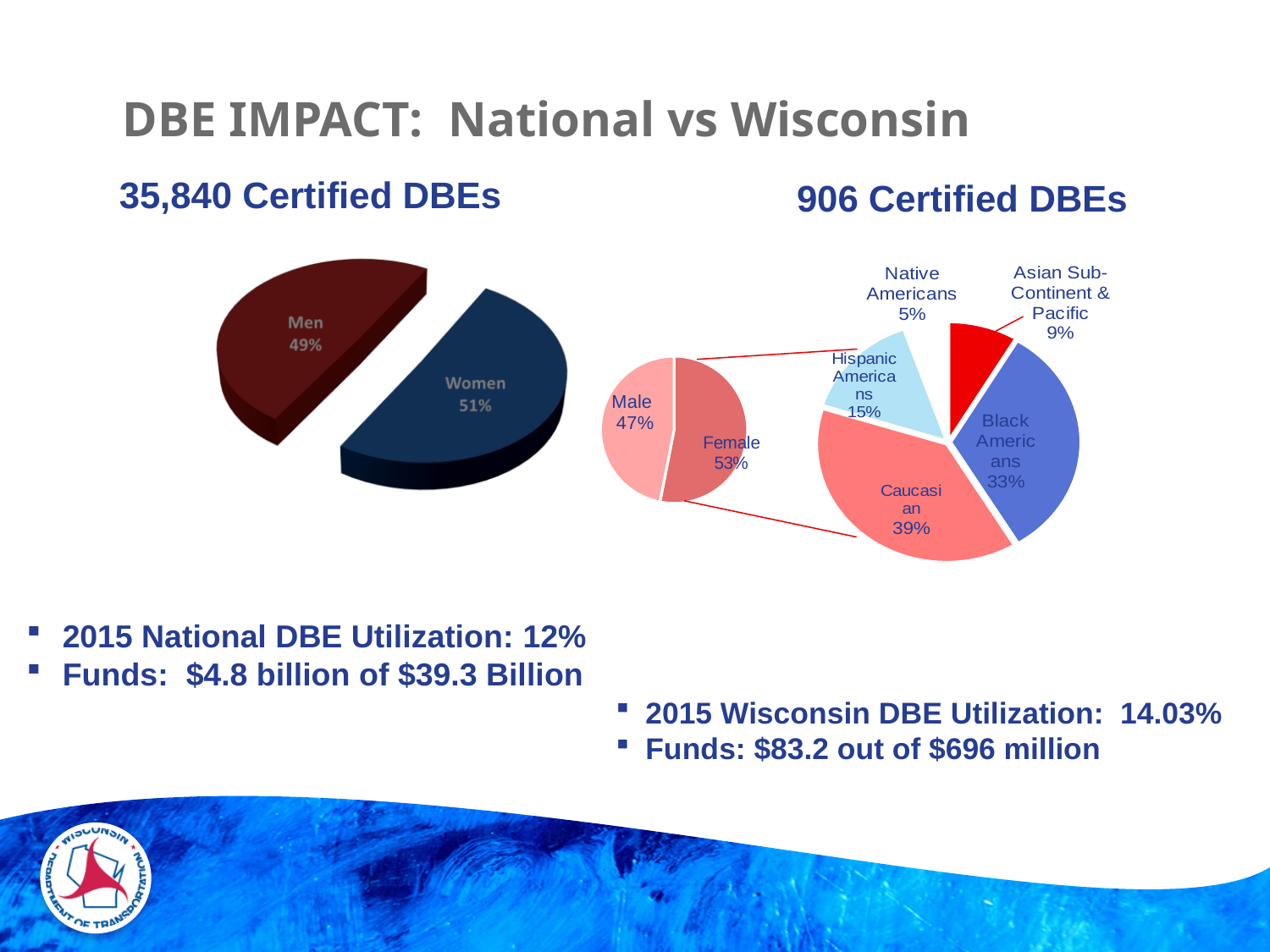
In the left pie chart (35,840 Certified DBEs), what percentage is shown for Men? 49% What kind of chart is the left chart (35,840 Certified DBEs)? Pie chart In the right chart (906 Certified DBEs), which group in the breakdown pie has the smallest share? Native Americans In the left pie chart (35,840 Certified DBEs), what percentage is shown for Women? 51% In the right chart (906 Certified DBEs), what percentage is shown for Female? 53% In the right chart (906 Certified DBEs), which group in the breakdown pie has the largest share? Caucasian In the right chart (906 Certified DBEs), how many groups are shown in the breakdown pie? 5 In the right chart (906 Certified DBEs), what is the difference between the Caucasian share and the Black Americans share? 6% In the right chart (906 Certified DBEs), what percentage is shown for Hispanic Americans? 15% In the right chart (906 Certified DBEs), what percentage is shown for Black Americans? 33% In the right chart (906 Certified DBEs), what percentage is shown for Male? 47% In the left pie chart (35,840 Certified DBEs), which slice is larger, Men or Women? Women